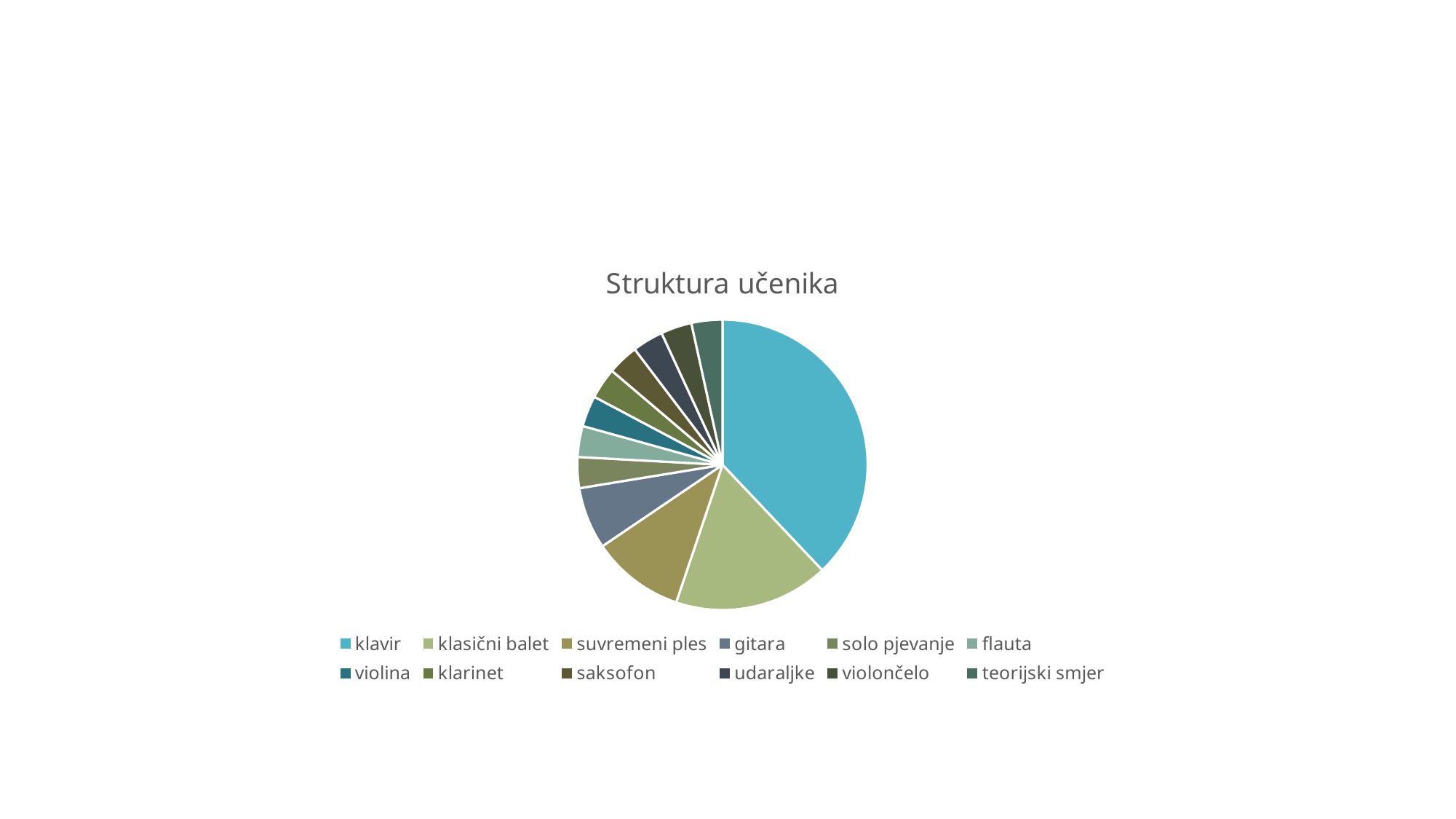
Which slice is larger, klavir or gitara? klavir What kind of chart is shown on the slide? pie chart Which slice is larger, gitara or solo pjevanje? gitara Which slice is larger, suvremeni ples or flauta? suvremeni ples Which category has the second largest slice of the pie? klasični balet Which category has the largest slice of the pie? klavir Does the klavir slice take up more or less than half of the pie? less What is the title of the chart? Struktura učenika Which legend entry is listed first? klavir How many categories does the pie chart have? 12